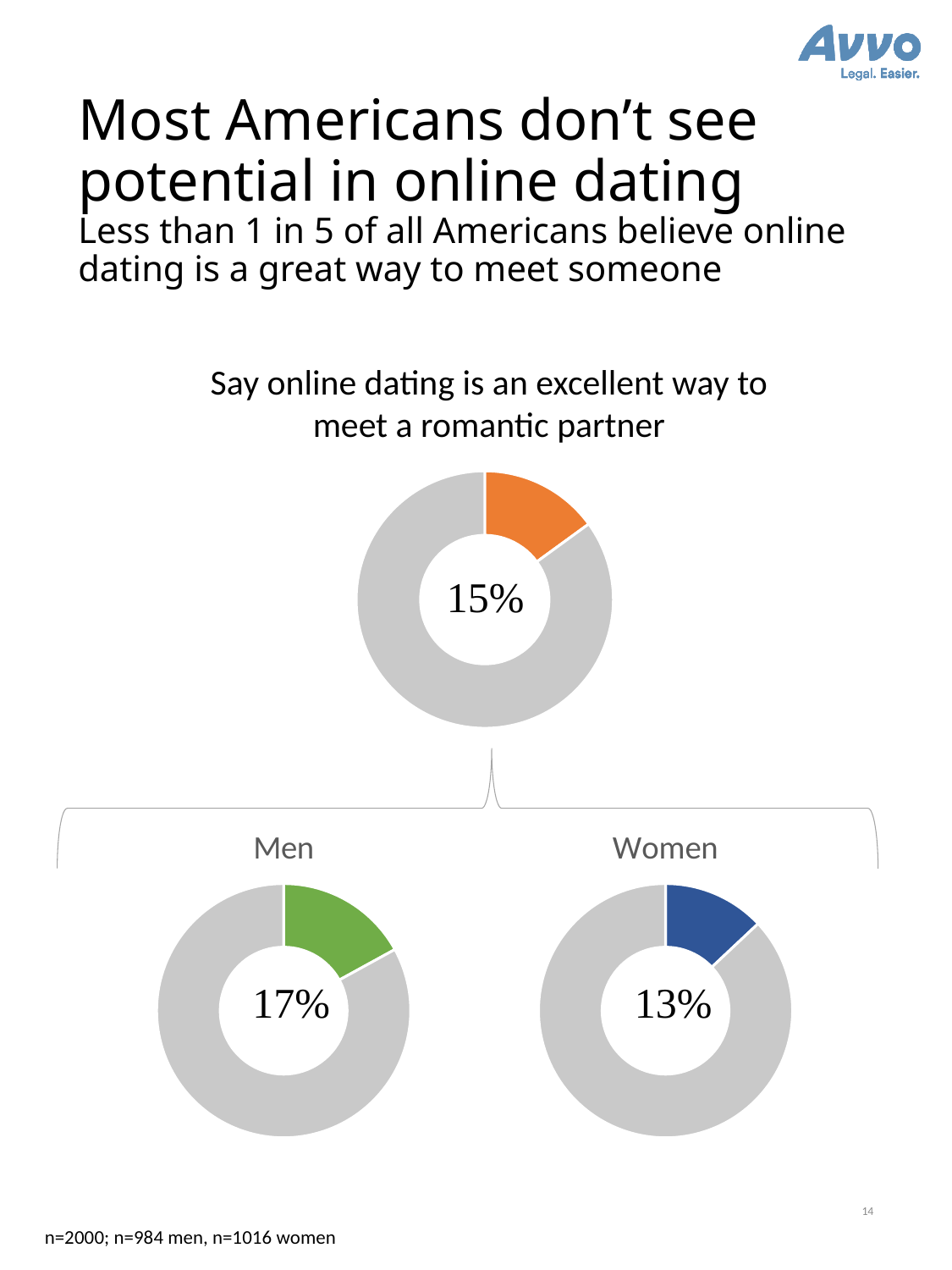
What is the difference between the percentage in the 'Men' chart and the percentage in the 'Women' chart? 4% Comparing the 'Men' and 'Women' charts, which group has the higher percentage? Men In the bottom-left chart labelled 'Men', what percentage is shown? 17% What is the difference between the percentage in the 'Men' chart and the percentage in the top overall chart? 2% In the 'Men' chart, what colour is the highlighted slice? Green In the bottom-right chart labelled 'Women', what percentage is shown? 13% How many doughnut charts are shown on the slide? 3 What kind of chart is the top chart titled 'Say online dating is an excellent way to meet a romantic partner'? Doughnut chart In the top chart, what share of the doughnut is coloured orange? 15% Of the three charts on the slide, which one shows the lowest percentage? Women In the top chart titled 'Say online dating is an excellent way to meet a romantic partner', what percentage is shown in the centre? 15% In the 'Women' chart, what colour is the highlighted slice? Blue